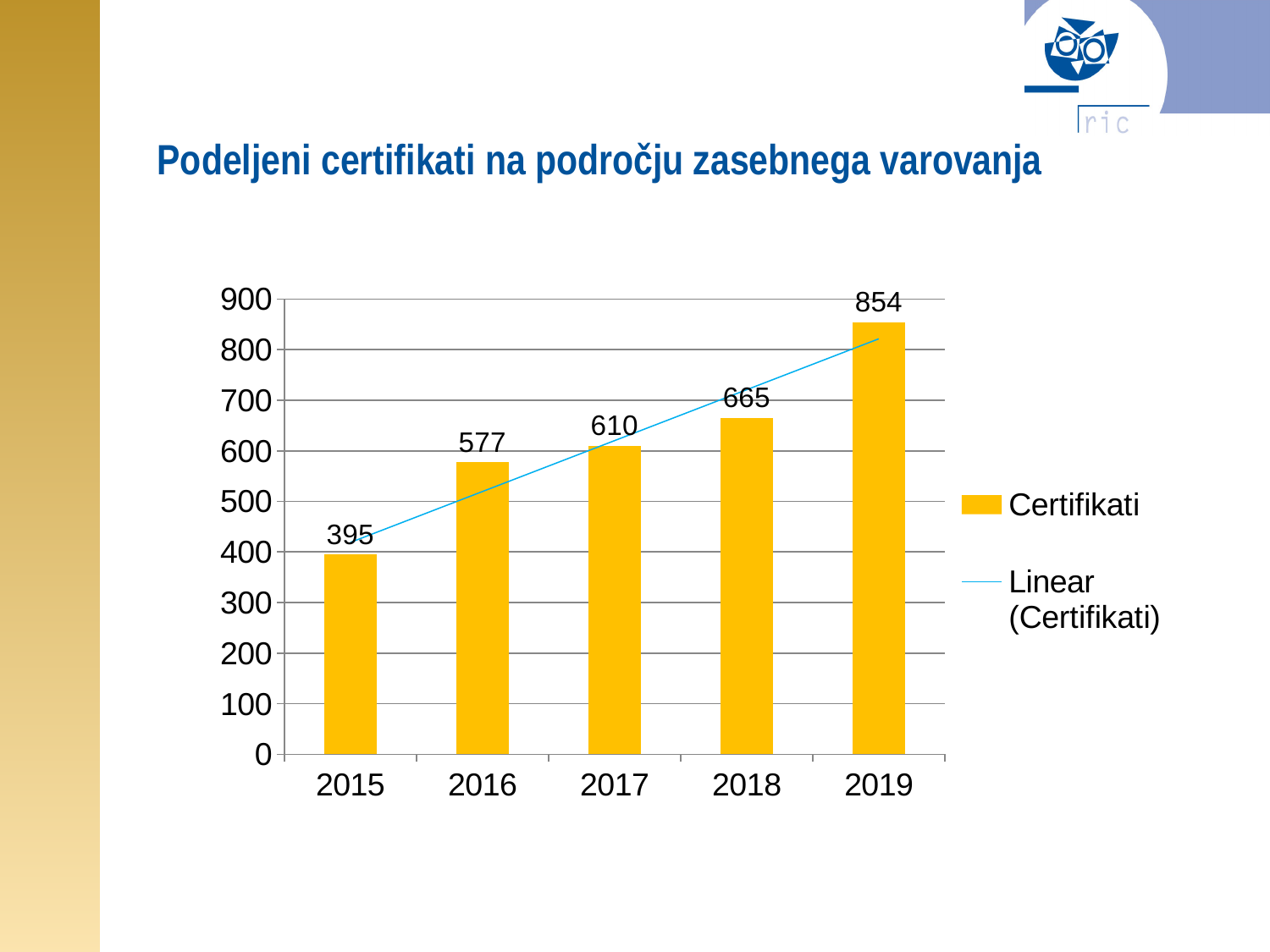
What is the value for 2015? 395 What is the difference between the values for 2019 and 2018? 189 What is the value for 2019? 854 What is the value for 2017? 610 Which is larger, the value for 2016 or the value for 2018? 2018 Which year has the highest value? 2019 How many years are shown on the x axis? 5 Which year has the lowest value? 2015 What kind of chart is this? bar chart Is the value for 2017 greater or less than 500? greater What is the difference between the values for 2016 and 2015? 182 Do the values rise or fall from 2015 to 2019? rise